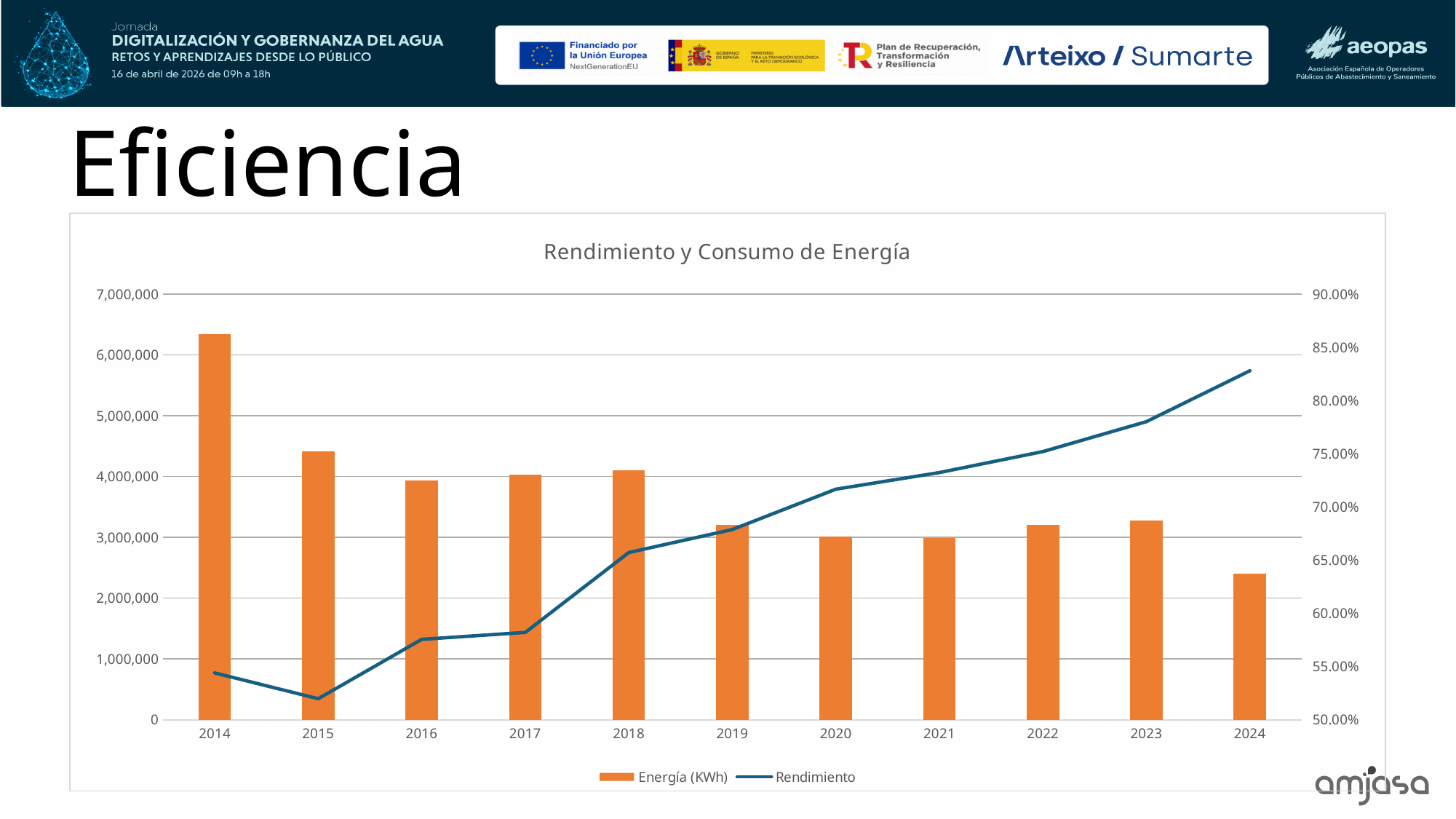
What kind of chart is shown on the slide? A combined bar and line chart Is the Rendimiento value for 2024 greater or less than 80.00%? greater What is the title of the chart? Rendimiento y Consumo de Energía How many years are shown along the x axis of the chart? 11 Is the Energía (KWh) value for 2014 greater or less than 6,000,000? greater In which year is the Rendimiento line at its highest point? 2024 How many series does the chart legend list? 2 Does the Rendimiento line generally rise or fall from 2015 to 2024? rise In which year is the Energía (KWh) bar the highest? 2014 In which year is the Rendimiento line at its lowest point? 2015 Which year has a higher Energía (KWh) value, 2015 or 2019? 2015 In which year is the Energía (KWh) bar the lowest? 2024